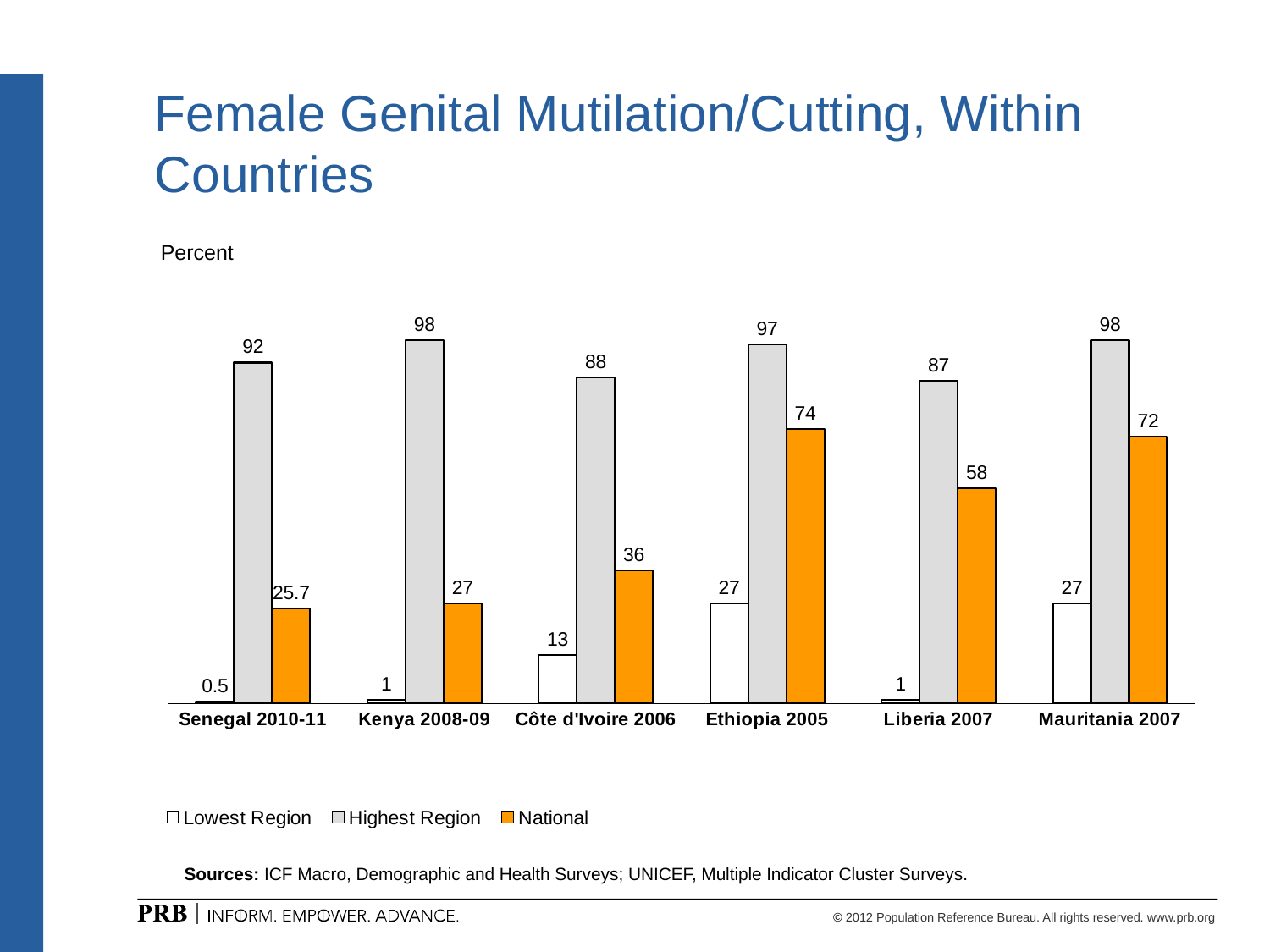
Which country has the lowest Highest Region value? Liberia 2007 What is the difference between the Highest Region and National values for Kenya 2008-09? 71 What is the Lowest Region value for Senegal 2010-11? 0.5 What is the Highest Region value for Côte d'Ivoire 2006? 88 Which series is shown in orange? National How many series does the legend list? 3 Which country has the highest National value? Ethiopia 2005 What is the National value for Ethiopia 2005? 74 What kind of chart is shown on the slide? Bar chart How many countries are shown on the x axis? 6 What is the National value for Senegal 2010-11? 25.7 Which is larger, the National value for Liberia 2007 or the National value for Mauritania 2007? Mauritania 2007